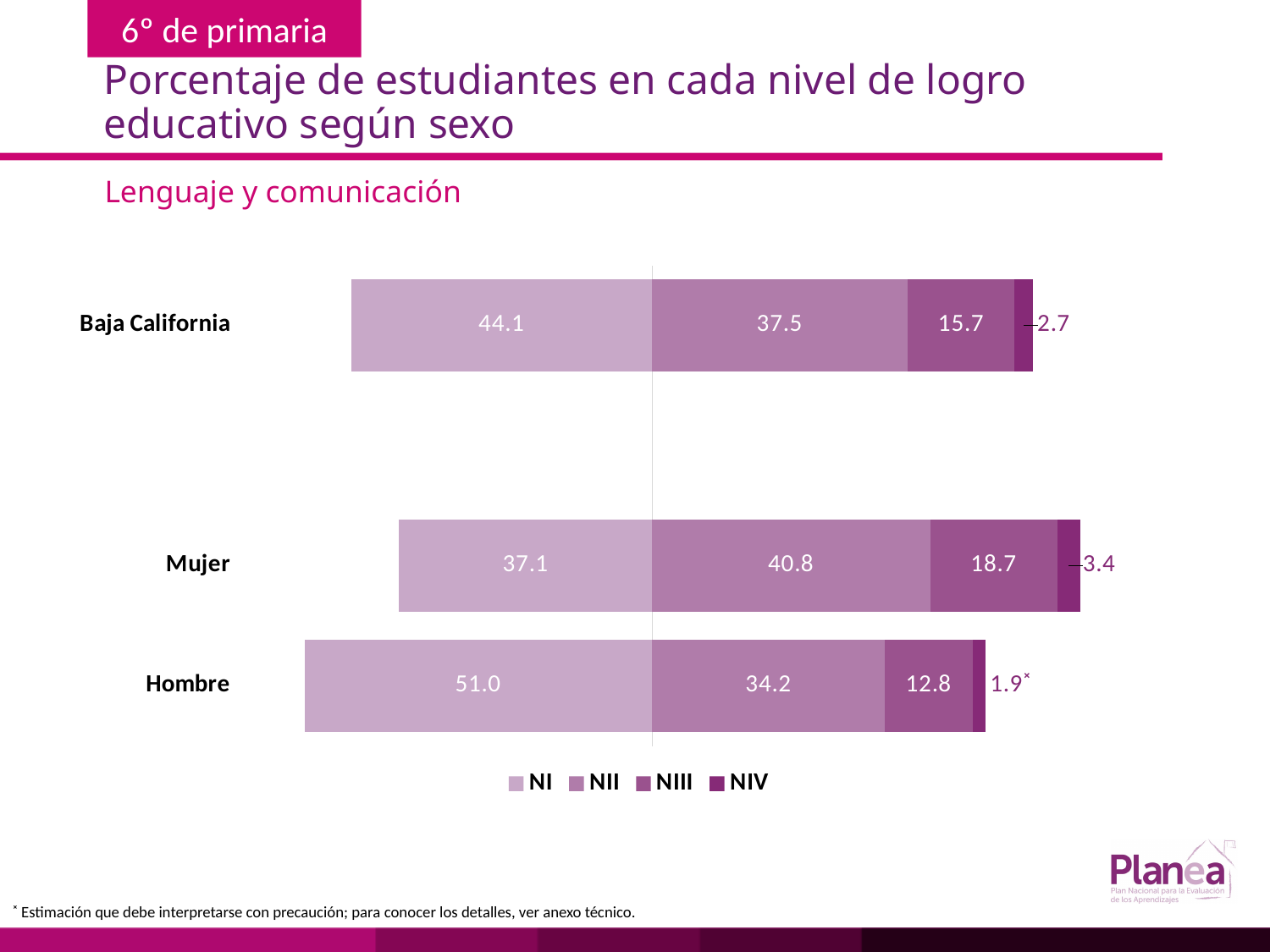
How many series does the legend list? 4 What is the NIV value for Mujer? 3.4 How many categories are shown on the chart? 3 What is the NIII value for Baja California? 15.7 What is the difference between the NI values for Hombre and Mujer? 13.9 What kind of chart is shown on the slide? Stacked bar chart Which is larger, the NII value for Baja California or the NII value for Hombre? Baja California What is the difference between the NIII values for Mujer and Hombre? 5.9 Which category has the lowest NIV value? Hombre What is the NII value for Mujer? 40.8 What is the NI value for Hombre? 51.0 Which category has the highest NI value? Hombre